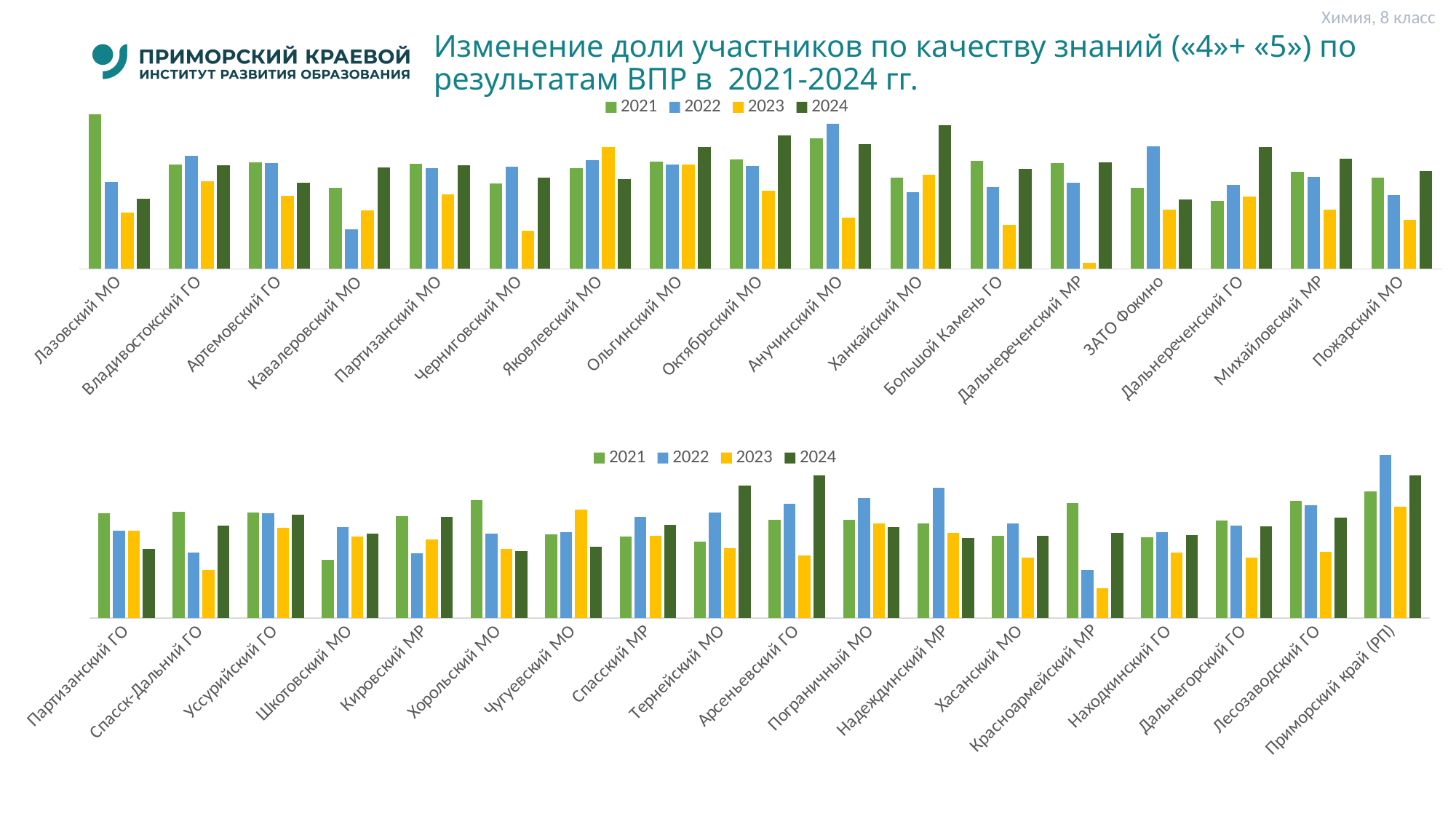
In the bottom chart, which year has the lowest bar for Красноармейский МР? 2023 How many categories (municipalities) are shown on the x axis of the top chart? 17 Which colour represents the 2023 series in the legend of the charts? yellow How many categories are shown on the x axis of the bottom chart? 18 In the top chart, which year has the lowest bar for Дальнереченский МР? 2023 In the top chart, which year has the highest bar for Анучинский МО? 2022 In the bottom chart, for Хорольский МО, is the 2021 bar or the 2024 bar larger? 2021 How many series does the legend of the top chart list? 4 What kind of chart is the top chart on the slide? bar chart In the bottom chart, which year has the highest bar for Приморский край (РП)? 2022 In the bottom chart, do the bars for Красноармейский МР rise or fall from 2021 to 2023? fall In the top chart, for Лазовский МО, is the 2021 bar or the 2023 bar larger? 2021